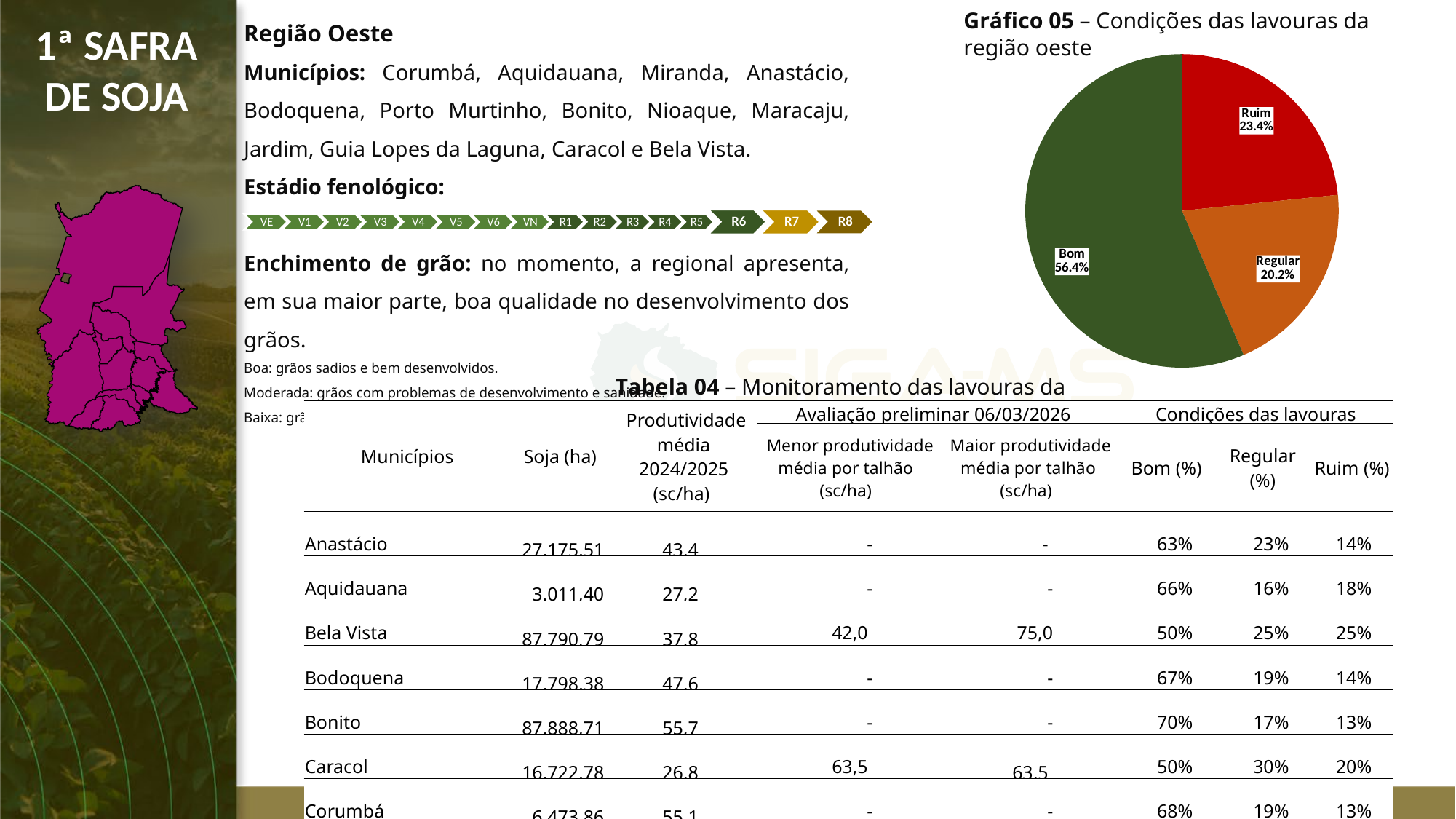
In Gráfico 05, which slice is larger, Ruim or Regular? Ruim What is the title of the pie chart on the slide? Gráfico 05 – Condições das lavouras da região oeste In Gráfico 05, what colour is the Bom slice? dark green In Gráfico 05, what share of the pie is labelled Ruim? 23.4% How many slices does the pie in Gráfico 05 have? 3 In Gráfico 05, what share of the pie is labelled Regular? 20.2% In Gráfico 05, which category has the smallest slice? Regular What kind of chart is Gráfico 05? pie chart In Gráfico 05, which category has the largest slice? Bom In Gráfico 05, what is the difference in percentage points between the Bom and Ruim slices? 33.0 In Gráfico 05, what share of the pie is labelled Bom? 56.4% In Gráfico 05, what is the difference in percentage points between the Ruim and Regular slices? 3.2